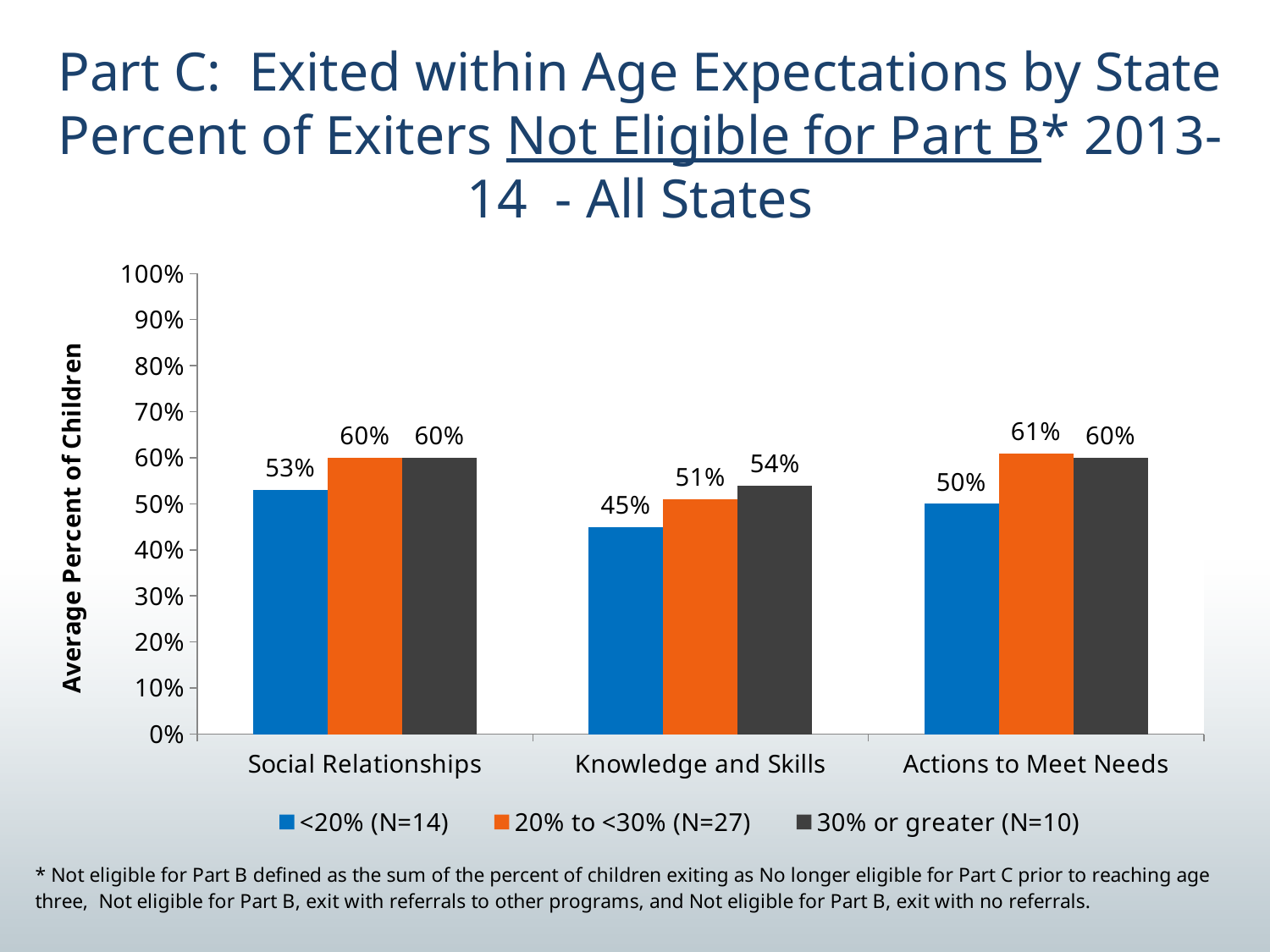
How many series does the legend list? 3 What is the y-axis label of the chart? Average Percent of Children What kind of chart is shown on the slide? Bar chart What is the difference between the 30% or greater (N=10) value and the <20% (N=14) value for Knowledge and Skills? 9% Which category has the highest value in the 20% to <30% (N=27) series? Actions to Meet Needs What colour are the bars for the 20% to <30% (N=27) series? Orange What is the value for Knowledge and Skills in the 20% to <30% (N=27) series? 51% What is the value for Actions to Meet Needs in the 30% or greater (N=10) series? 60% Which category has the lowest value in the <20% (N=14) series? Knowledge and Skills How many categories are shown on the x axis? 3 What is the value for Social Relationships in the <20% (N=14) series? 53% Which is larger for Actions to Meet Needs: the <20% (N=14) value or the 20% to <30% (N=27) value? 20% to <30% (N=27)